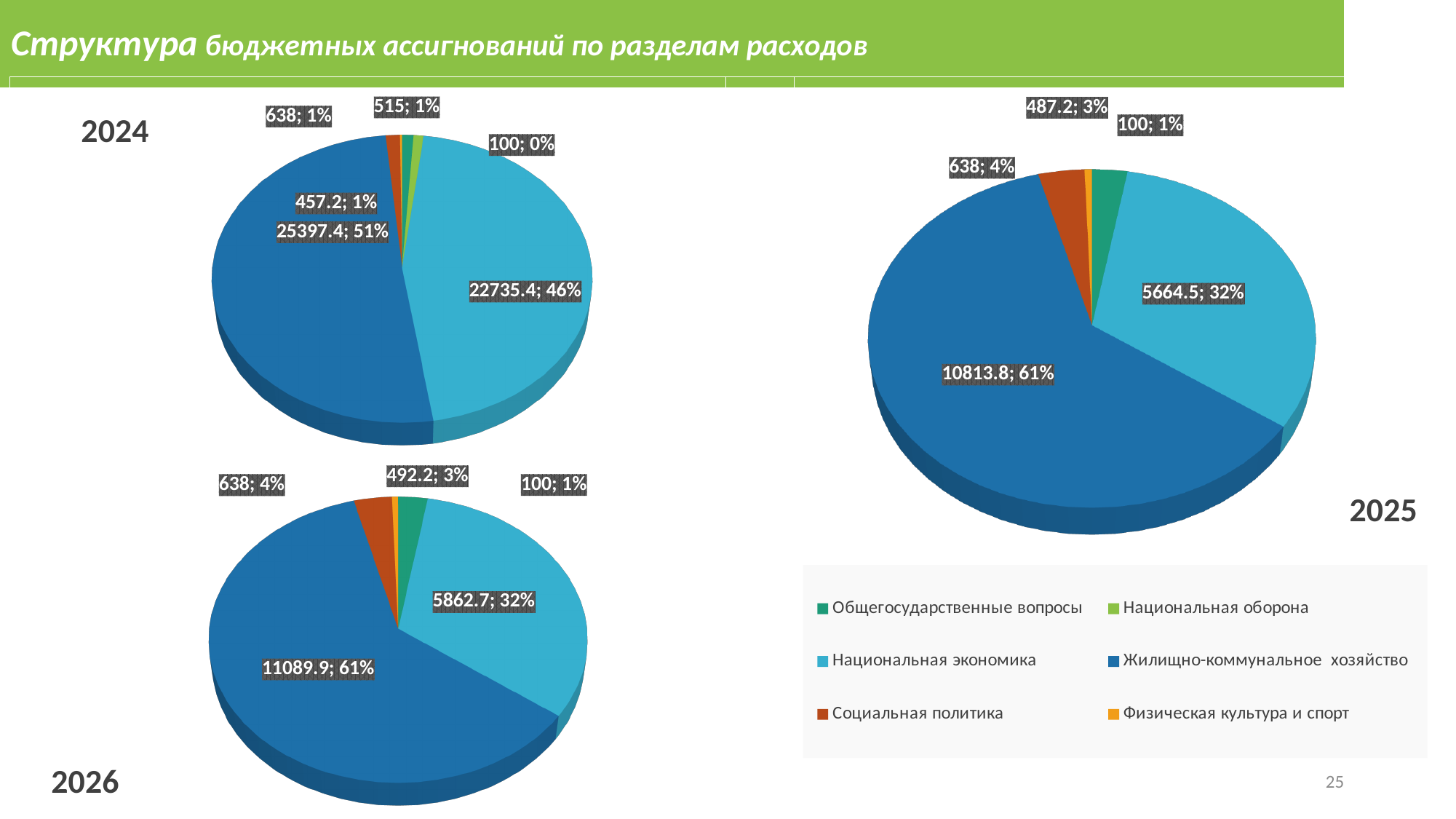
In the 2026 pie chart, which category has the largest slice? Жилищно-коммунальное хозяйство In the 2025 pie chart, what is the difference between the values for Жилищно-коммунальное хозяйство and Национальная экономика? 5149.3 In the 2026 pie chart, what is the difference between the values for Жилищно-коммунальное хозяйство and Национальная экономика? 5227.2 What kind of charts are shown on the slide? Pie charts In the 2025 pie chart, what is the value for Социальная политика? 638 In the 2024 pie chart, what is the value for Жилищно-коммунальное хозяйство? 25397.4 In the 2024 pie chart, what share does Национальная экономика have? 46% In the 2025 pie chart, what share does Жилищно-коммунальное хозяйство have? 61% In the 2025 pie chart, what is the value for Жилищно-коммунальное хозяйство? 10813.8 In the 2026 pie chart, what is the value for Национальная экономика? 5862.7 In the 2024 pie chart, which is larger: Жилищно-коммунальное хозяйство or Национальная экономика? Жилищно-коммунальное хозяйство How many entries does the legend list? 6